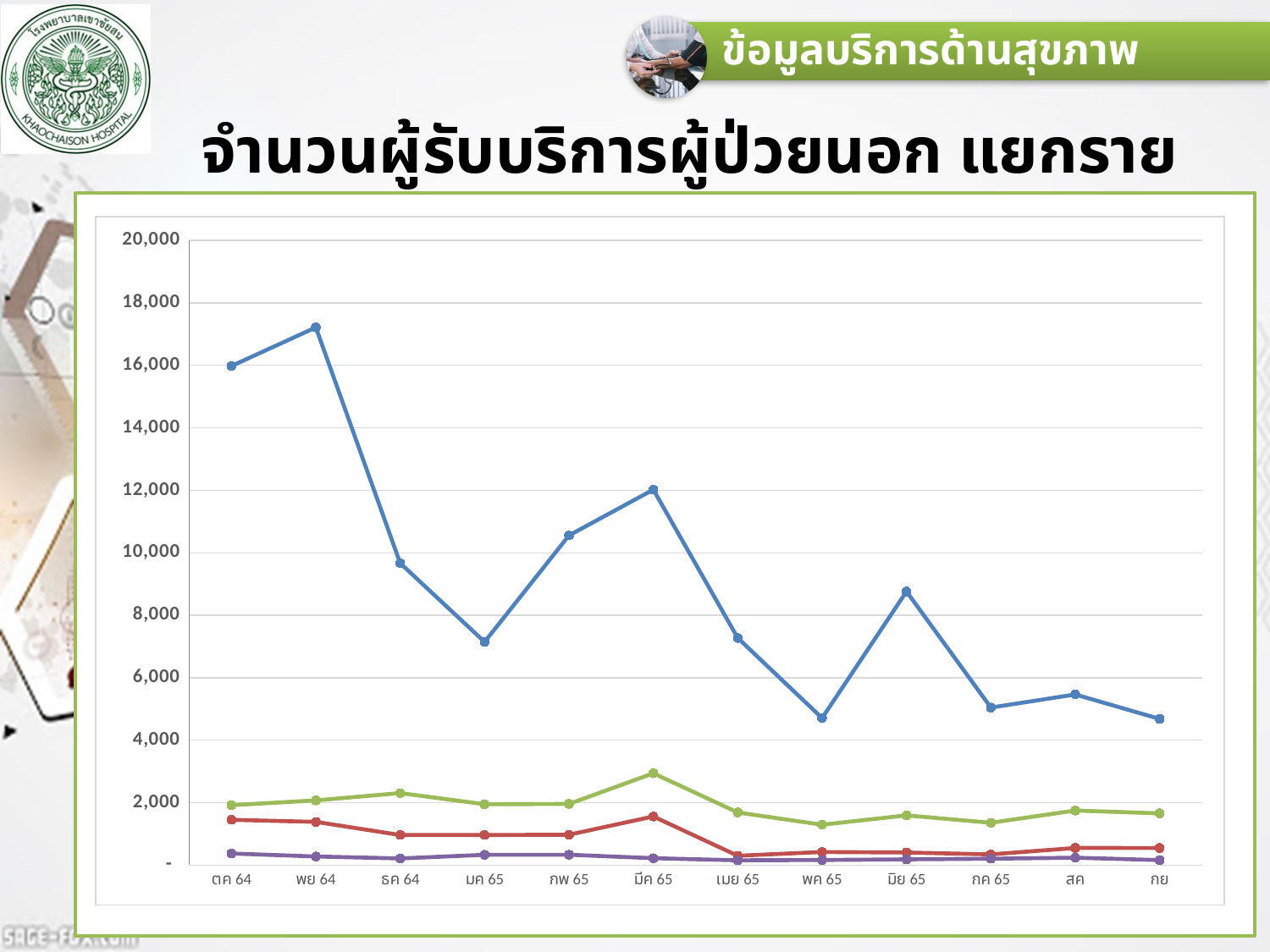
Is the value of the green line for มีค 65 greater or less than 2,000? greater How many months are shown along the x axis of the chart? 12 Does the blue line rise or fall from มีค 65 to พค 65? fall Is the value of the blue line for มค 65 greater or less than 8,000? less What kind of chart is shown on the slide? Line chart Is the value of the blue line for มีค 65 greater or less than 10,000? greater In which month does the blue line reach its highest value? พย 64 For the blue line, which month has the larger value, ธค 64 or มค 65? ธค 64 For the blue line, which month has the larger value, กพ 65 or มีค 65? มีค 65 How many lines are plotted on the chart? 4